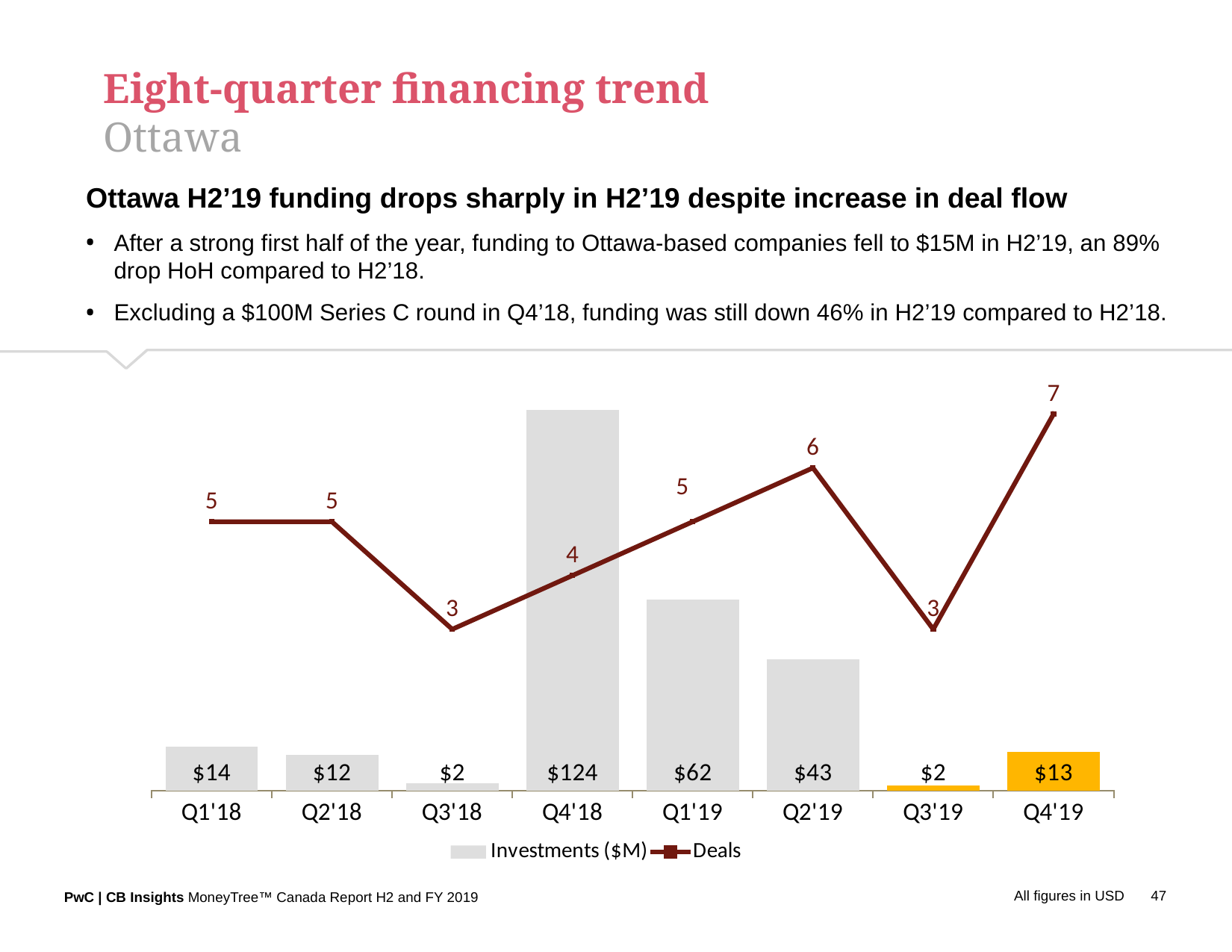
Do the Deals rise or fall from Q3'19 to Q4'19? Rise Which quarter has the lowest number of Deals? Q3'18 and Q3'19 Which quarter has the highest Investments ($M) value? Q4'18 Which quarter has more Deals, Q2'19 or Q1'19? Q2'19 What is the difference in Investments ($M) between Q1'19 and Q2'19? $19 What is the Investments ($M) value for Q3'19? $2 How many Deals were there in Q4'19? 7 What kind of chart is this? Combined bar and line chart How many quarters are shown on the x axis? 8 What are the two series named in the legend? Investments ($M) and Deals How many series does the legend list? 2 What is the Investments ($M) value for Q4'18? $124